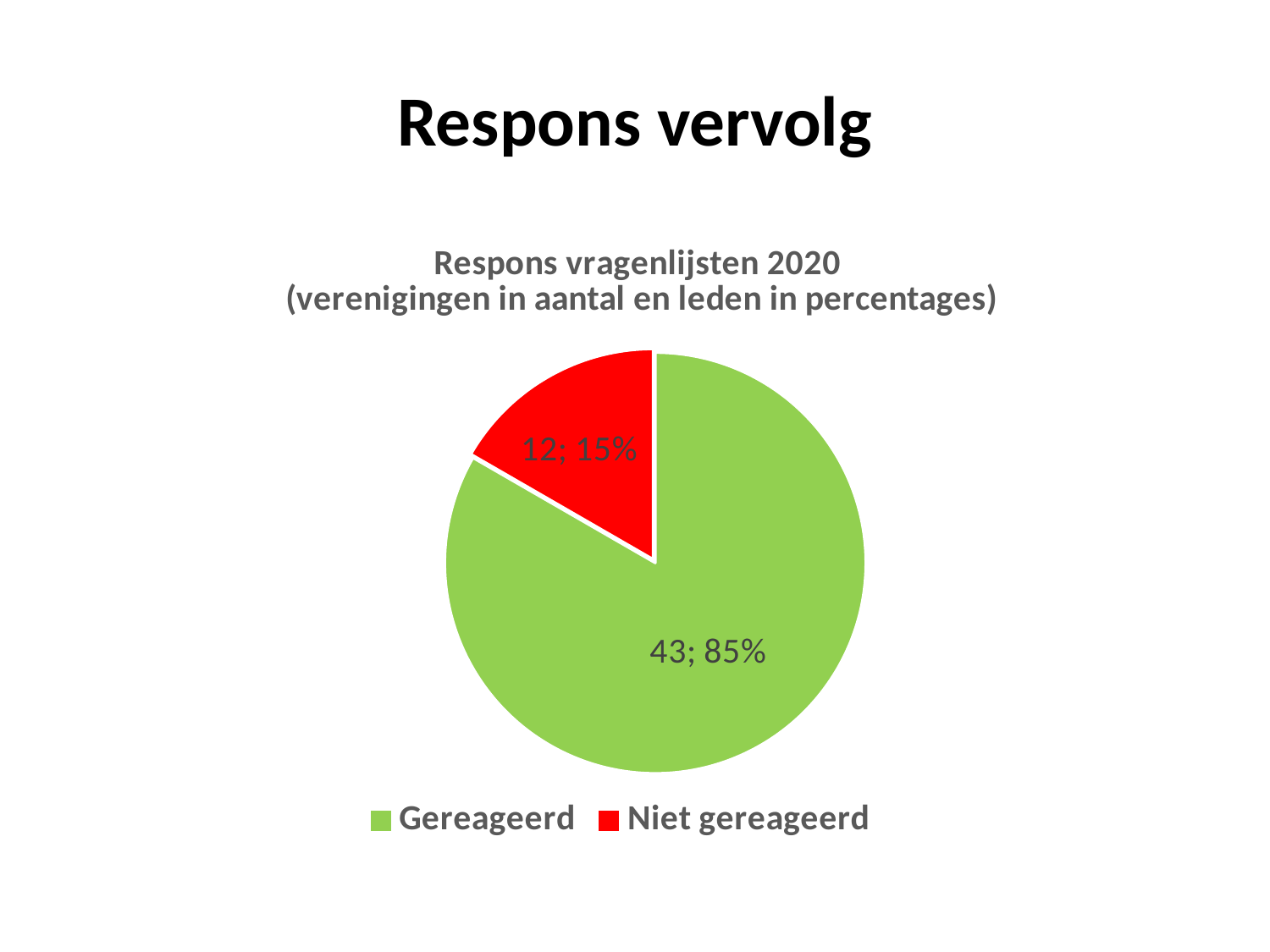
Which colour represents Niet gereageerd? red How many slices does the pie chart have? 2 How many entries does the legend list? 2 What is the title of the chart? Respons vragenlijsten 2020 (verenigingen in aantal en leden in percentages) What is the number of associations (aantal) for Niet gereageerd? 12 Which slice is the largest? Gereageerd What kind of chart is shown on the slide? pie chart What percentage share of the pie does Niet gereageerd have? 15% Which slice is the smallest? Niet gereageerd What percentage share of the pie does Gereageerd have? 85% What is the difference in count between Gereageerd and Niet gereageerd? 31 What is the number of associations (aantal) for Gereageerd? 43